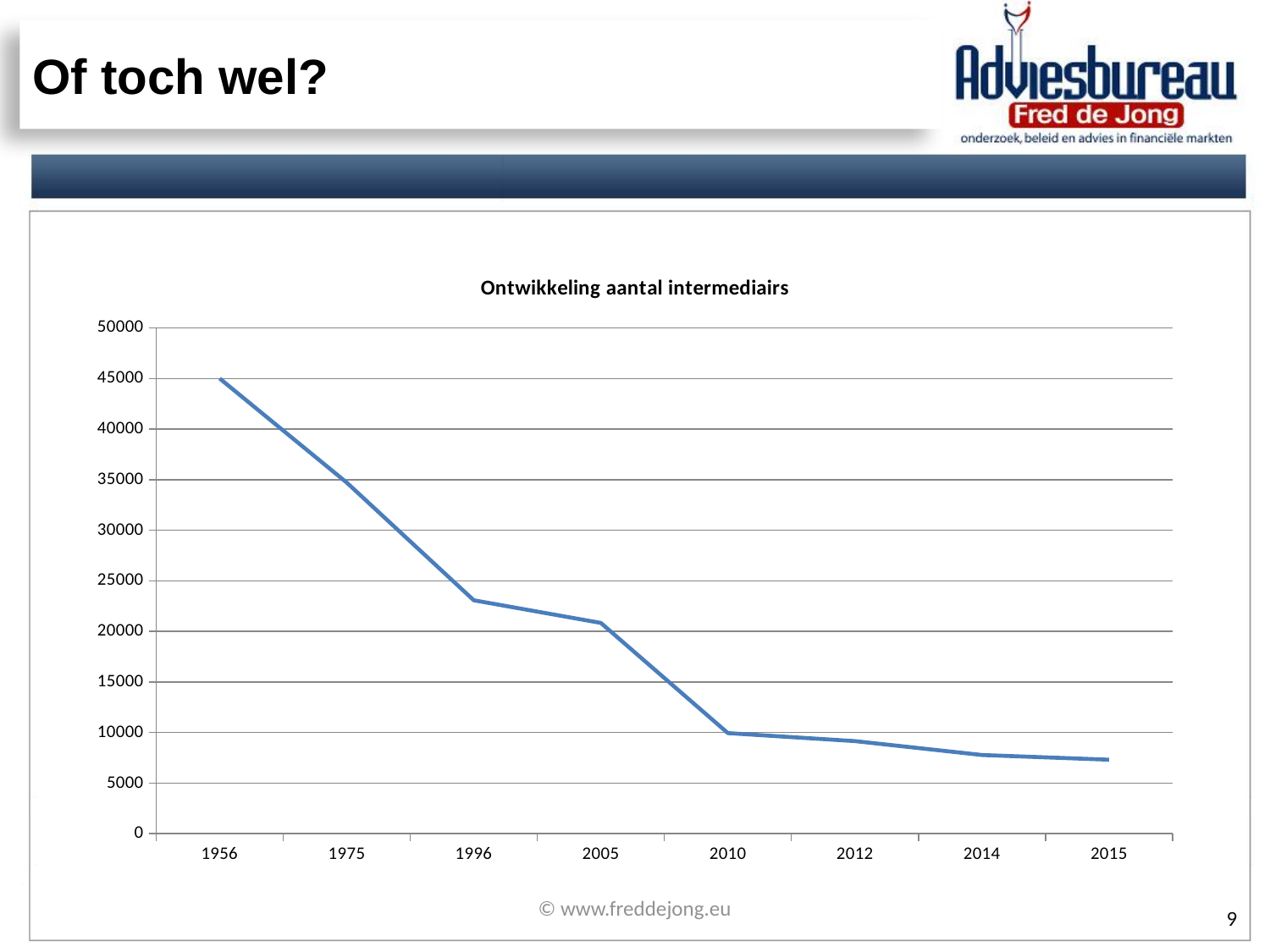
Is the value for 2014 greater or less than 10000? less Is the value for 1996 greater or less than 20000? greater What is the title of the chart? Ontwikkeling aantal intermediairs What kind of chart is shown on the slide? line chart Is the value for 2015 greater or less than 5000? greater Which year has the highest value? 1956 Which year has the lowest value? 2015 Do the values rise or fall from 1956 to 2015? fall How many years are plotted along the x axis? 8 Which is larger, the value for 1996 or the value for 2005? 1996 What is the value for 1956? 45000